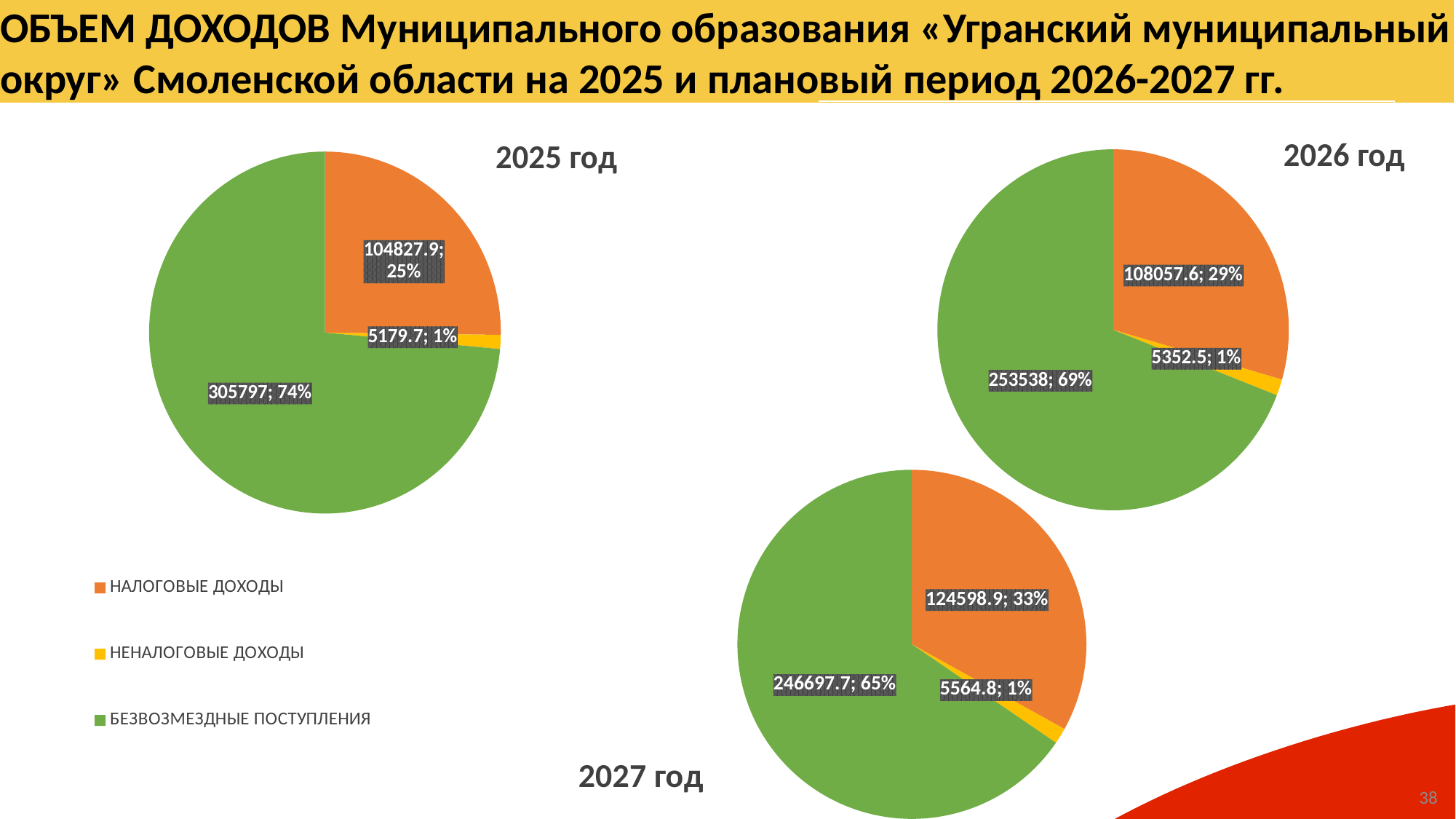
Which colour represents НЕНАЛОГОВЫЕ ДОХОДЫ in the legend? Yellow In the 2025 год chart, which category has the smallest slice? НЕНАЛОГОВЫЕ ДОХОДЫ What type of chart is used for the 2025 год data? Pie chart In the 2026 год chart, what share of the pie is НАЛОГОВЫЕ ДОХОДЫ? 29% In the 2026 год chart, what is the difference between the values for БЕЗВОЗМЕЗДНЫЕ ПОСТУПЛЕНИЯ and НАЛОГОВЫЕ ДОХОДЫ? 145480.4 How many slices does the 2026 год chart have? 3 In the 2025 год chart, what value is shown for НАЛОГОВЫЕ ДОХОДЫ? 104827.9 In the 2027 год chart, what value is shown for БЕЗВОЗМЕЗДНЫЕ ПОСТУПЛЕНИЯ? 246697.7 Which is larger: НАЛОГОВЫЕ ДОХОДЫ in the 2027 год chart or НАЛОГОВЫЕ ДОХОДЫ in the 2025 год chart? 2027 год In the 2026 год chart, what value is shown for НЕНАЛОГОВЫЕ ДОХОДЫ? 5352.5 In the 2027 год chart, which category has the largest slice? БЕЗВОЗМЕЗДНЫЕ ПОСТУПЛЕНИЯ In the 2025 год chart, what share of the pie is БЕЗВОЗМЕЗДНЫЕ ПОСТУПЛЕНИЯ? 74%